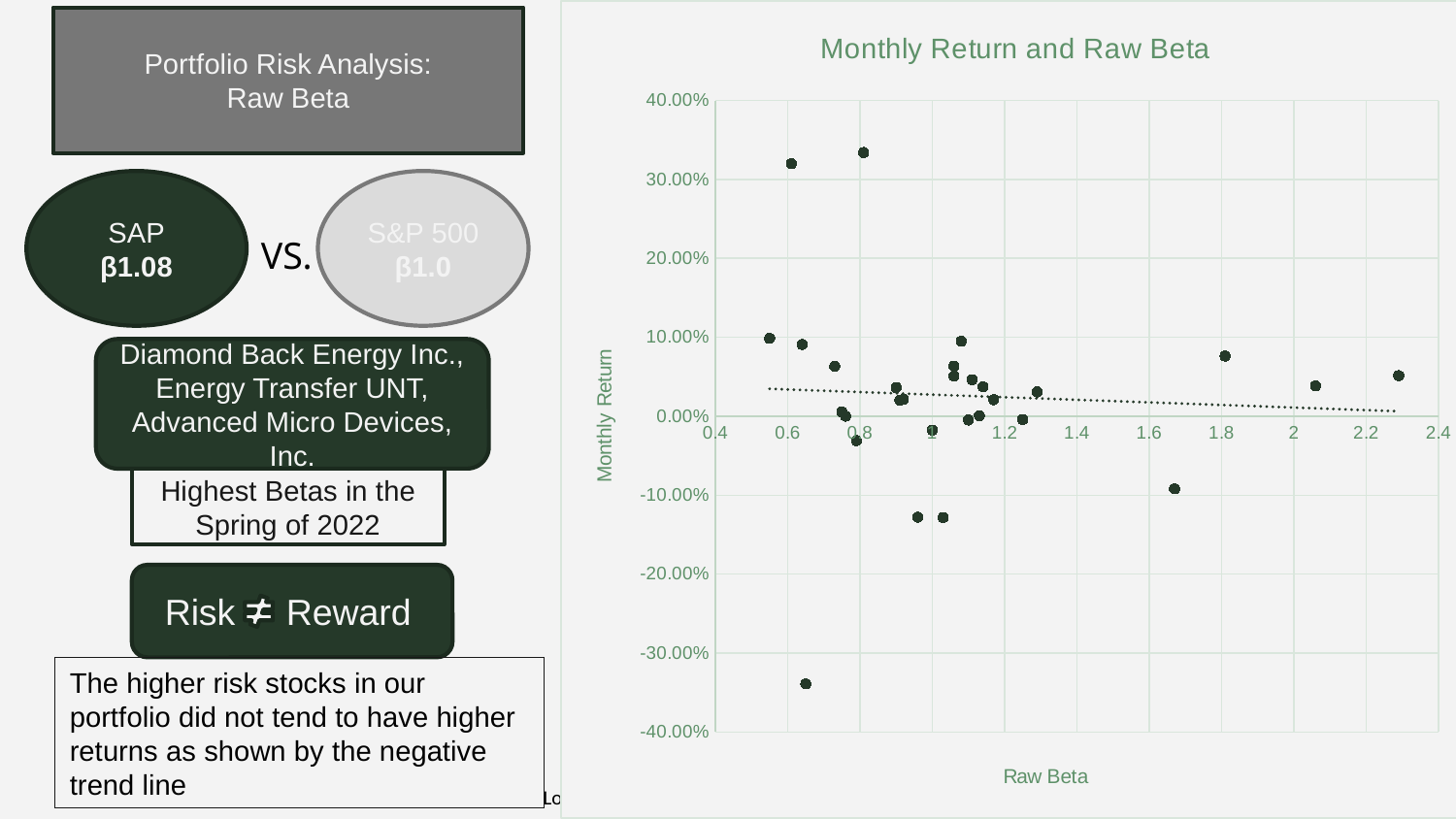
Is the Monthly Return of the point at a Raw Beta of about 1.67 greater or less than 0.00%? less Is the highest Monthly Return plotted in the chart greater or less than 30.00%? greater What is the title of the chart? Monthly Return and Raw Beta Is the smallest Raw Beta value plotted in the chart greater or less than 0.6? less Does the dotted trend line in the chart rise or fall as Raw Beta increases? fall What is the label of the horizontal axis of the chart? Raw Beta What kind of chart is shown on the slide? scatter chart